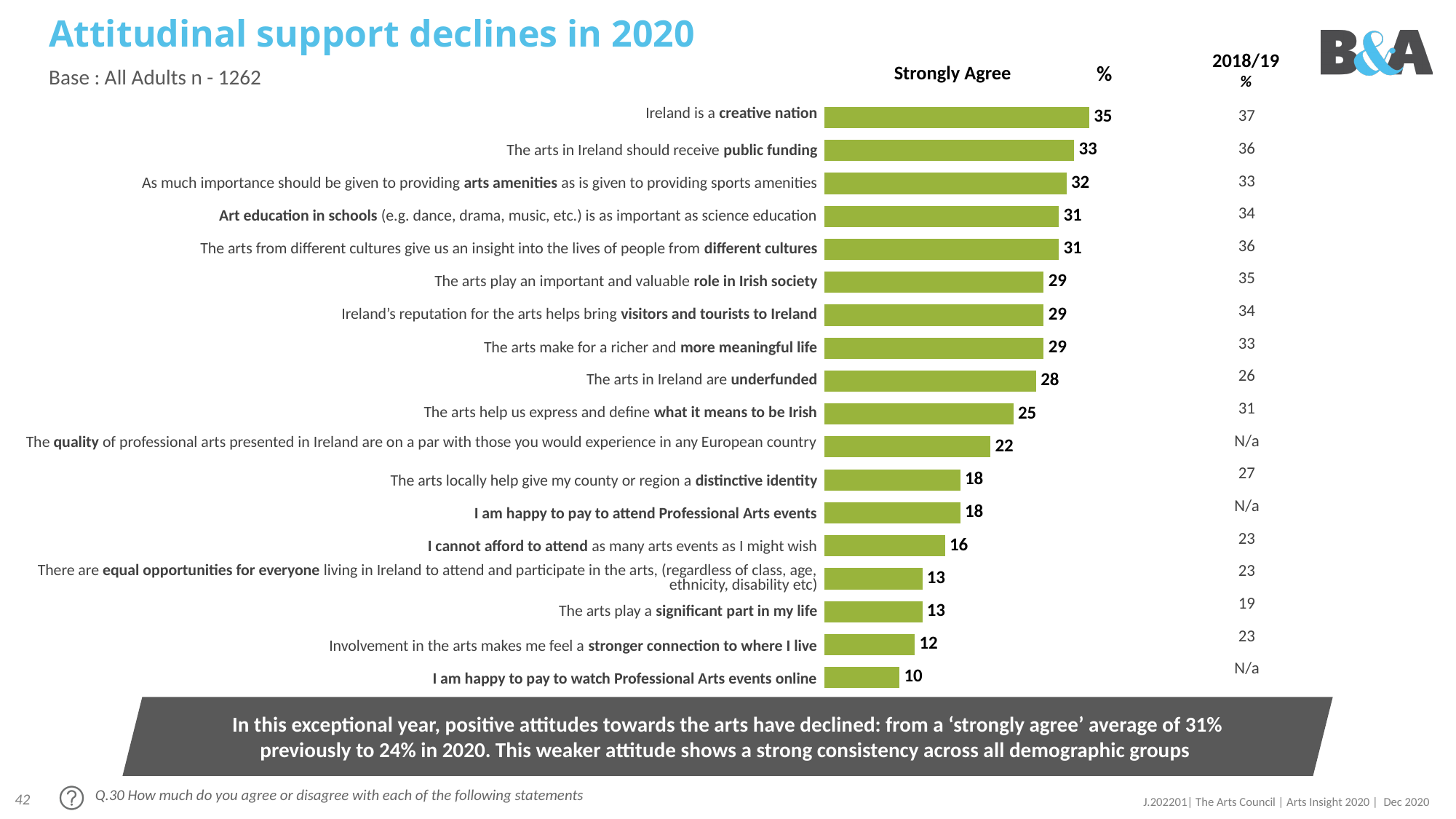
Which has a higher 'Strongly Agree' percentage: 'The arts play a significant part in my life' or 'I cannot afford to attend as many arts events as I might wish'? I cannot afford to attend as many arts events as I might wish What is the 'Strongly Agree' percentage for 'I am happy to pay to watch Professional Arts events online'? 10 How many statements are plotted in the bar chart? 18 What is the difference between the 2020 'Strongly Agree' percentage and the 2018/19 percentage for 'The arts locally help give my county or region a distinctive identity'? 9 What was the 2018/19 percentage for 'The arts play an important and valuable role in Irish society'? 35 What is the title of the slide? Attitudinal support declines in 2020 What is the 'Strongly Agree' percentage for 'The arts in Ireland are underfunded'? 28 What is the 'Strongly Agree' percentage for 'Ireland is a creative nation'? 35 What is the difference between the 'Strongly Agree' percentages for 'Ireland is a creative nation' and 'The arts in Ireland should receive public funding'? 2 What kind of chart is shown on the slide? Bar chart Which statement has the lowest 'Strongly Agree' percentage? I am happy to pay to watch Professional Arts events online Which statement has the highest 'Strongly Agree' percentage? Ireland is a creative nation